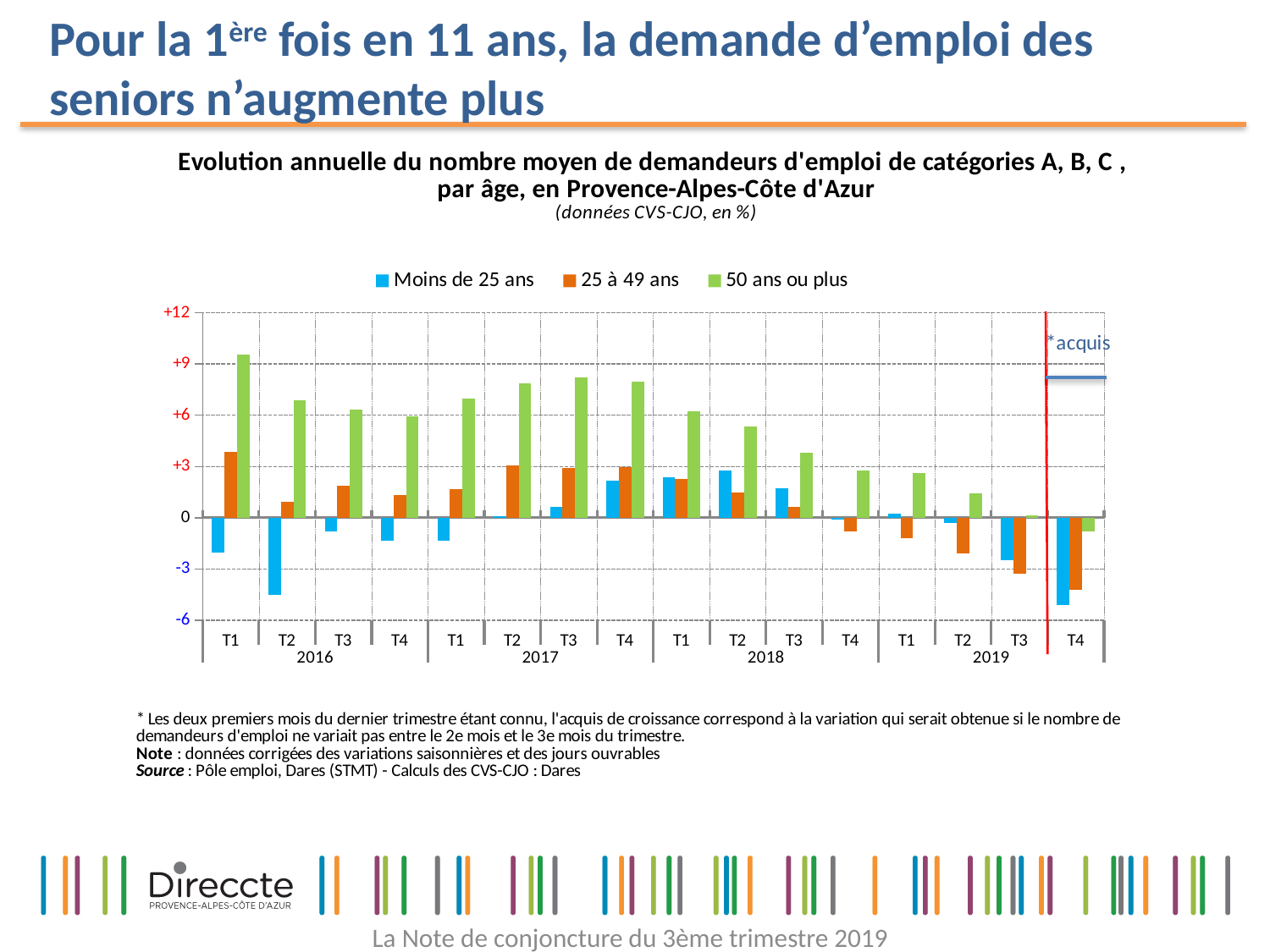
What kind of chart is shown on the slide? Bar chart Is the value for '50 ans ou plus' in T2 2019 greater or less than +3? less How many quarters are plotted along the x axis? 16 In which quarter is the value for '25 à 49 ans' the lowest? T4 2019 Is the value for '50 ans ou plus' in T1 2016 greater or less than +6? greater In which quarter is the value for '50 ans ou plus' the highest? T1 2016 Is the value for 'Moins de 25 ans' in T2 2016 greater or less than -3? less Does the value for '50 ans ou plus' rise or fall from T1 2018 to T4 2019? Fall Which age groups are listed in the legend? Moins de 25 ans, 25 à 49 ans, 50 ans ou plus How many series does the legend list? 3 In T1 2016, which is larger: the value for 'Moins de 25 ans' or for '50 ans ou plus'? 50 ans ou plus